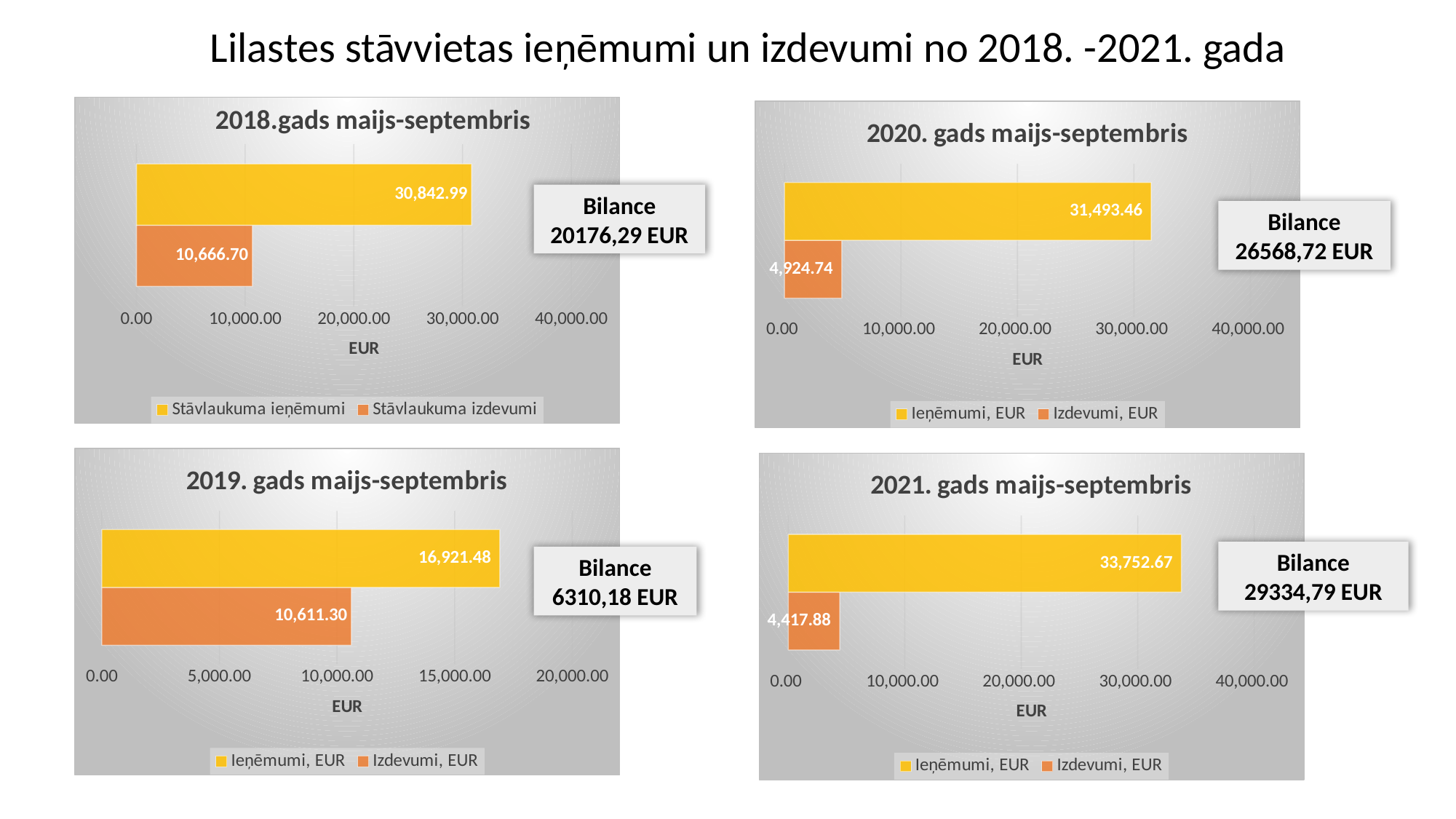
In the chart titled "2020. gads maijs-septembris", which is larger, Ieņēmumi, EUR or Izdevumi, EUR? Ieņēmumi, EUR How many series does the legend of the chart titled "2020. gads maijs-septembris" list? 2 What kind of chart is the chart titled "2018.gads maijs-septembris"? bar chart In the chart titled "2020. gads maijs-septembris", what is the value of Izdevumi, EUR? 4,924.74 In the chart titled "2019. gads maijs-septembris", what is the difference between Ieņēmumi, EUR and Izdevumi, EUR? 6,310.18 In the chart titled "2021. gads maijs-septembris", is the value of Ieņēmumi, EUR greater or less than 30,000.00? greater In the chart titled "2019. gads maijs-septembris", what is the value of Ieņēmumi, EUR? 16,921.48 In the chart titled "2021. gads maijs-septembris", what is the value of Izdevumi, EUR? 4,417.88 In the chart titled "2018.gads maijs-septembris", what is the value of Stāvlaukuma ieņēmumi? 30,842.99 In the chart titled "2021. gads maijs-septembris", what is the value of Ieņēmumi, EUR? 33,752.67 In the chart titled "2018.gads maijs-septembris", what is the value of Stāvlaukuma izdevumi? 10,666.70 What is the axis title shown below the horizontal axis of the chart titled "2019. gads maijs-septembris"? EUR